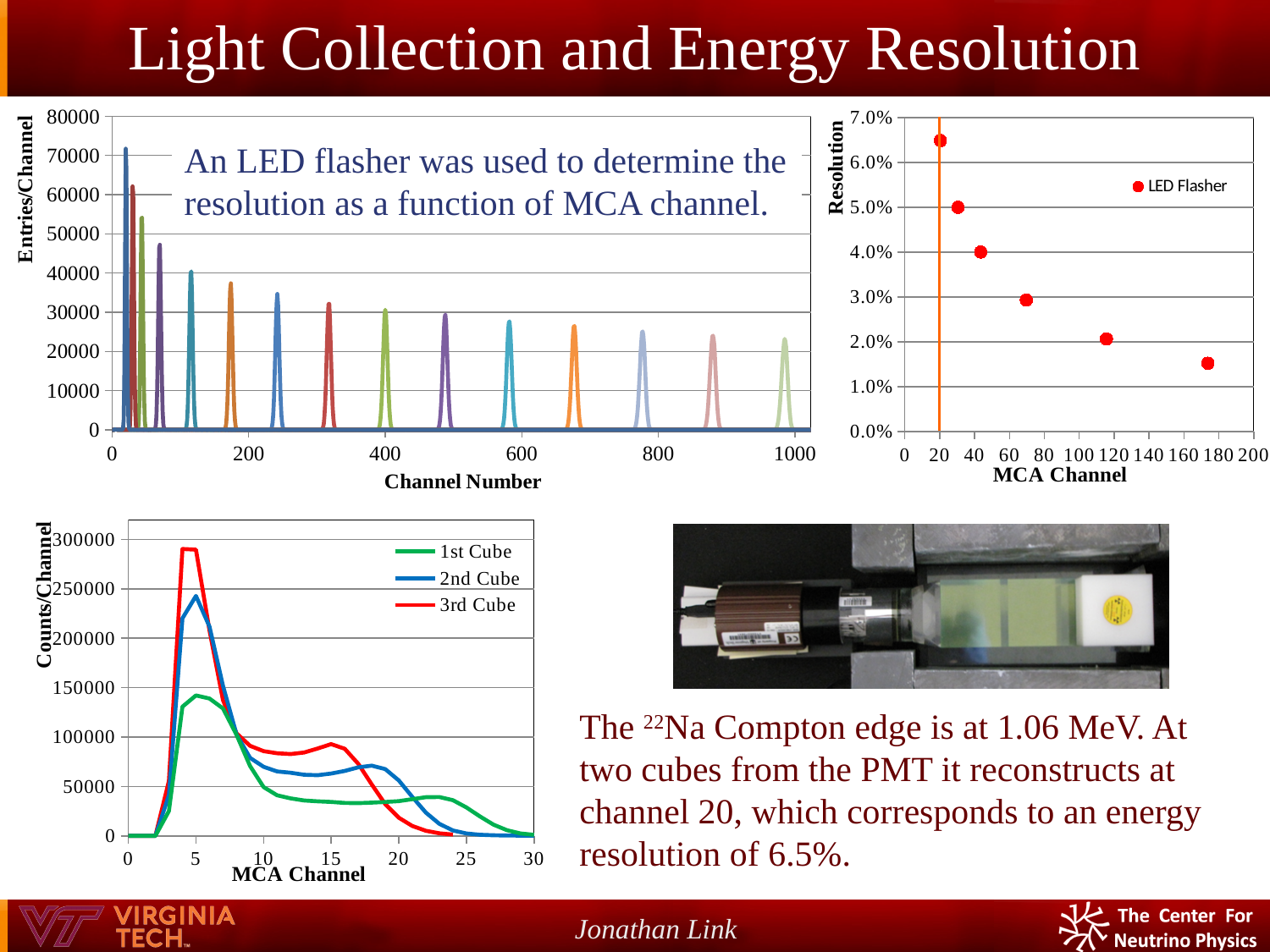
In the top-right chart (Resolution vs MCA Channel), is the resolution of the point at the lowest MCA channel greater or less than 6.0%? greater In the top-right chart (Resolution vs MCA Channel), how many series does the legend list? 1 In the top-right chart (Resolution vs MCA Channel), is the resolution of the point at the highest MCA channel greater or less than 2.0%? less In the top-right chart (Resolution vs MCA Channel), does the resolution rise or fall as the MCA channel increases? fall In the bottom-left chart (Counts/Channel vs MCA Channel), which series reaches the highest peak? 3rd Cube In the bottom-left chart (Counts/Channel vs MCA Channel), which series has the lowest peak? 1st Cube In the top-right chart (Resolution vs MCA Channel), what is the name of the series shown in the legend? LED Flasher In the bottom-left chart (Counts/Channel vs MCA Channel), how many series does the legend list? 3 In the bottom-left chart (Counts/Channel vs MCA Channel), is the peak of the 3rd Cube series greater or less than 250000? greater In the top-right chart (Resolution vs MCA Channel), how many data points are plotted? 6 What kind of chart is the bottom-left chart (Counts/Channel vs MCA Channel)? line chart In the top-left chart (Entries/Channel vs Channel Number), do the peak heights rise or fall as the channel number increases? fall